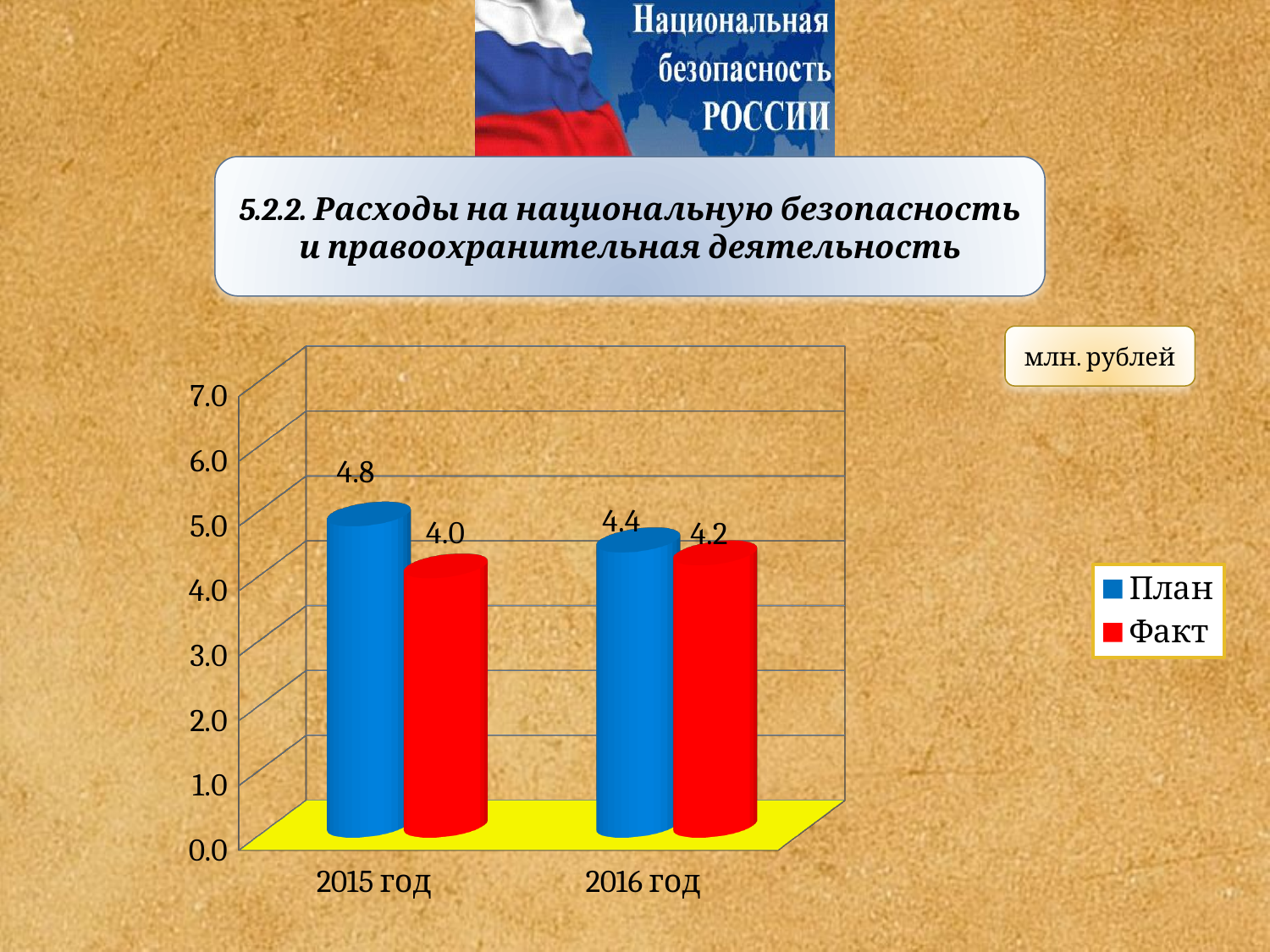
What unit is indicated for the chart values? млн. рублей Which year has the lowest Факт value? 2015 год What is the Факт value for 2015 год? 4.0 What is the План value for 2016 год? 4.4 What kind of chart is shown on the slide? bar chart How many series does the legend list? 2 What is the План value for 2015 год? 4.8 What is the Факт value for 2016 год? 4.2 What is the difference between План and Факт for 2016 год? 0.2 What is the difference between План and Факт for 2015 год? 0.8 Which is larger for 2015 год, План or Факт? План Which year has the highest План value? 2015 год